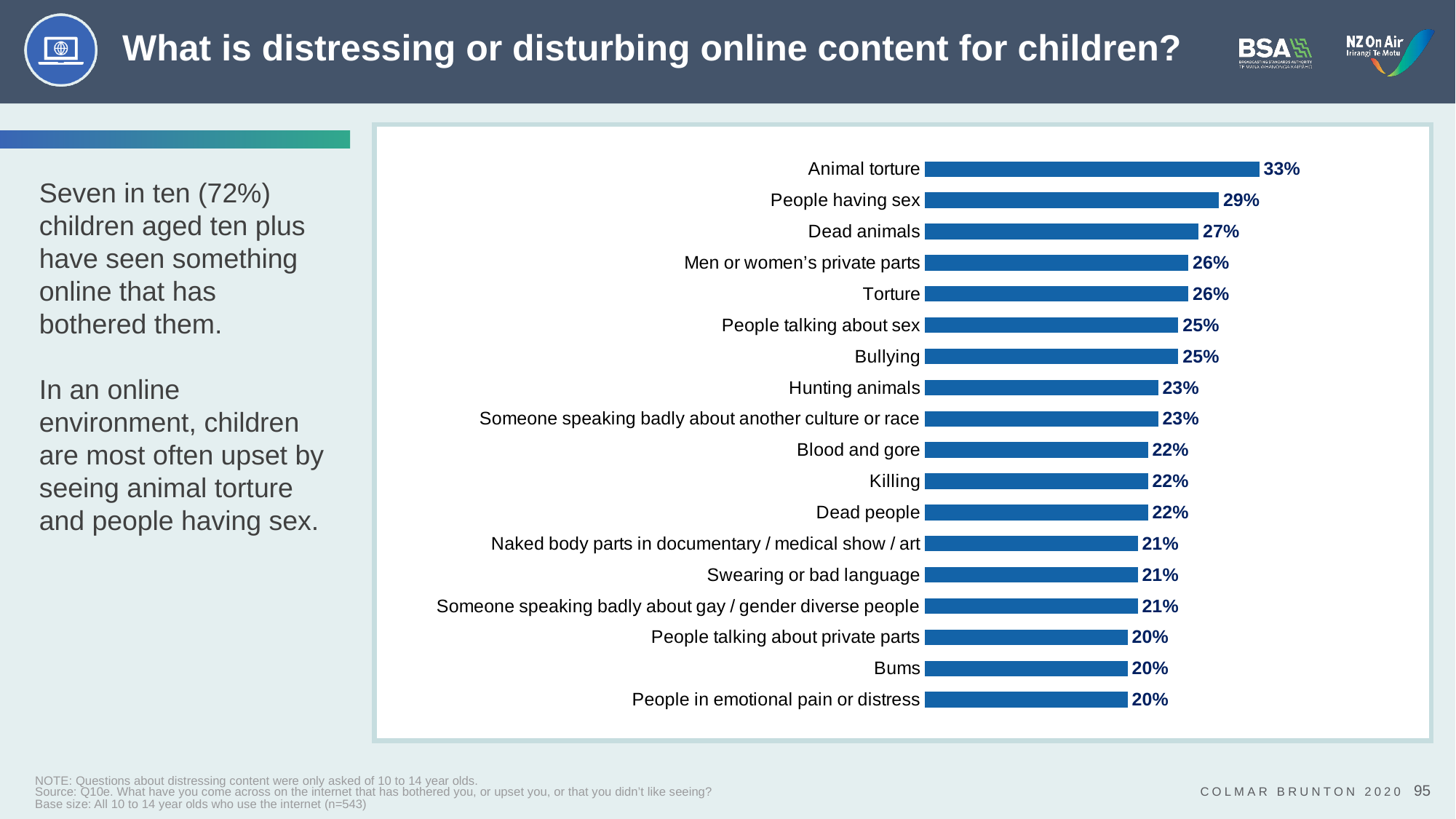
What percentage is shown for Swearing or bad language? 21% What percentage of children said animal torture was distressing online content? 33% What is the value for Dead animals? 27% What kind of chart is shown on the slide? Bar chart What is the difference between the values for Dead animals and Bums? 7% What is the value shown for Bullying? 25% Which has a larger value, Torture or People in emotional pain or distress? Torture How many categories are shown in the chart? 18 What is the difference between the values for Animal torture and People having sex? 4% What colour are the bars in the chart? Blue Which has a larger value, Hunting animals or Blood and gore? Hunting animals Which category has the highest value in the chart? Animal torture